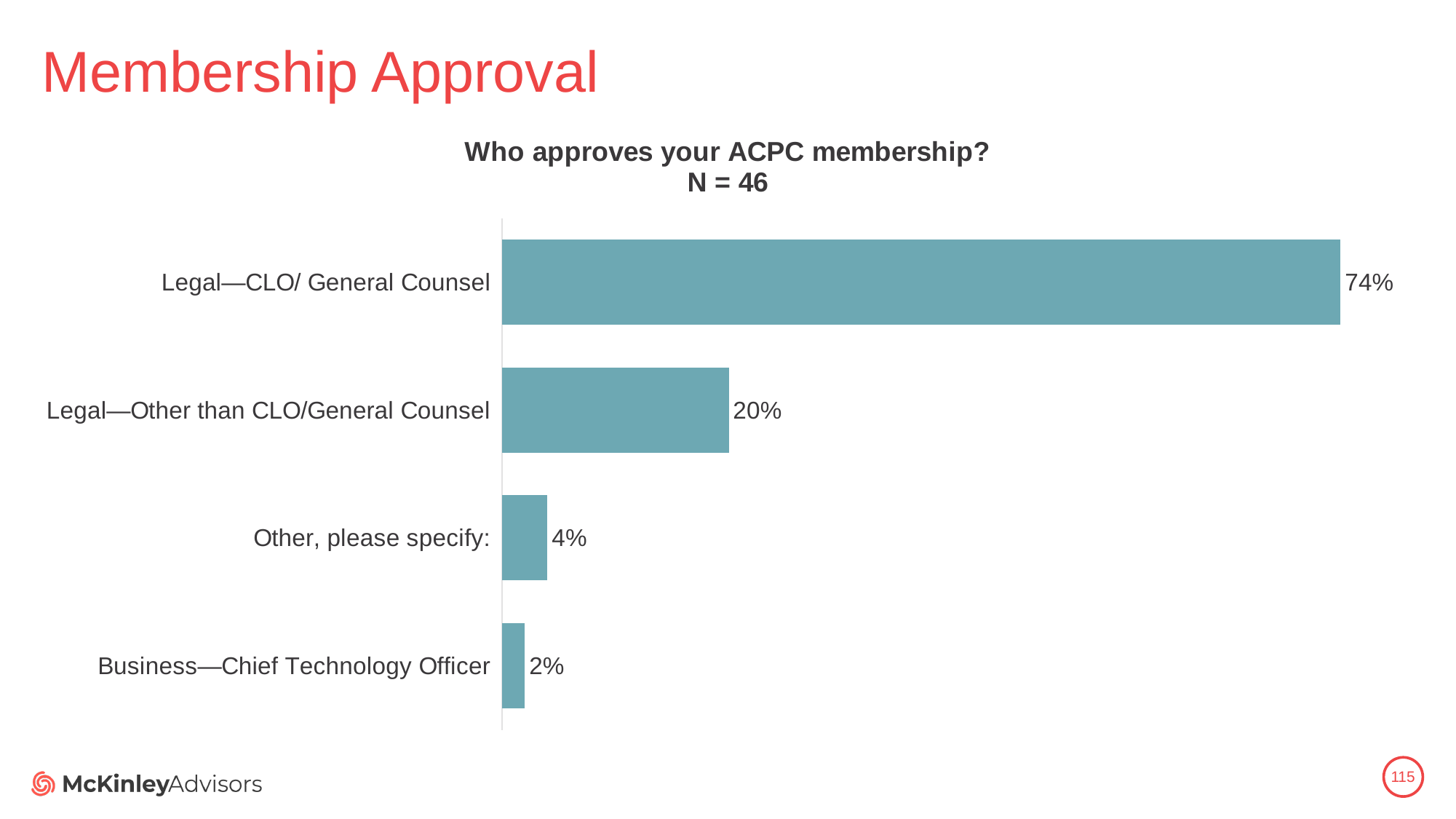
Which is larger: Legal—Other than CLO/General Counsel or Other, please specify? Legal—Other than CLO/General Counsel What is the difference between Other, please specify and Business—Chief Technology Officer? 2% What percentage of respondents said Legal—CLO/ General Counsel approves their ACPC membership? 74% Which category has the lowest value? Business—Chief Technology Officer What type of chart is shown on the slide? Bar chart What is the value for Business—Chief Technology Officer? 2% How many categories are shown in the chart? 4 What is the difference between the values for Legal—CLO/ General Counsel and Legal—Other than CLO/General Counsel? 54% Which category has the highest value? Legal—CLO/ General Counsel What is the value for Legal—Other than CLO/General Counsel? 20% What is the sample size (N) stated in the chart title? 46 What percentage is shown for Other, please specify? 4%